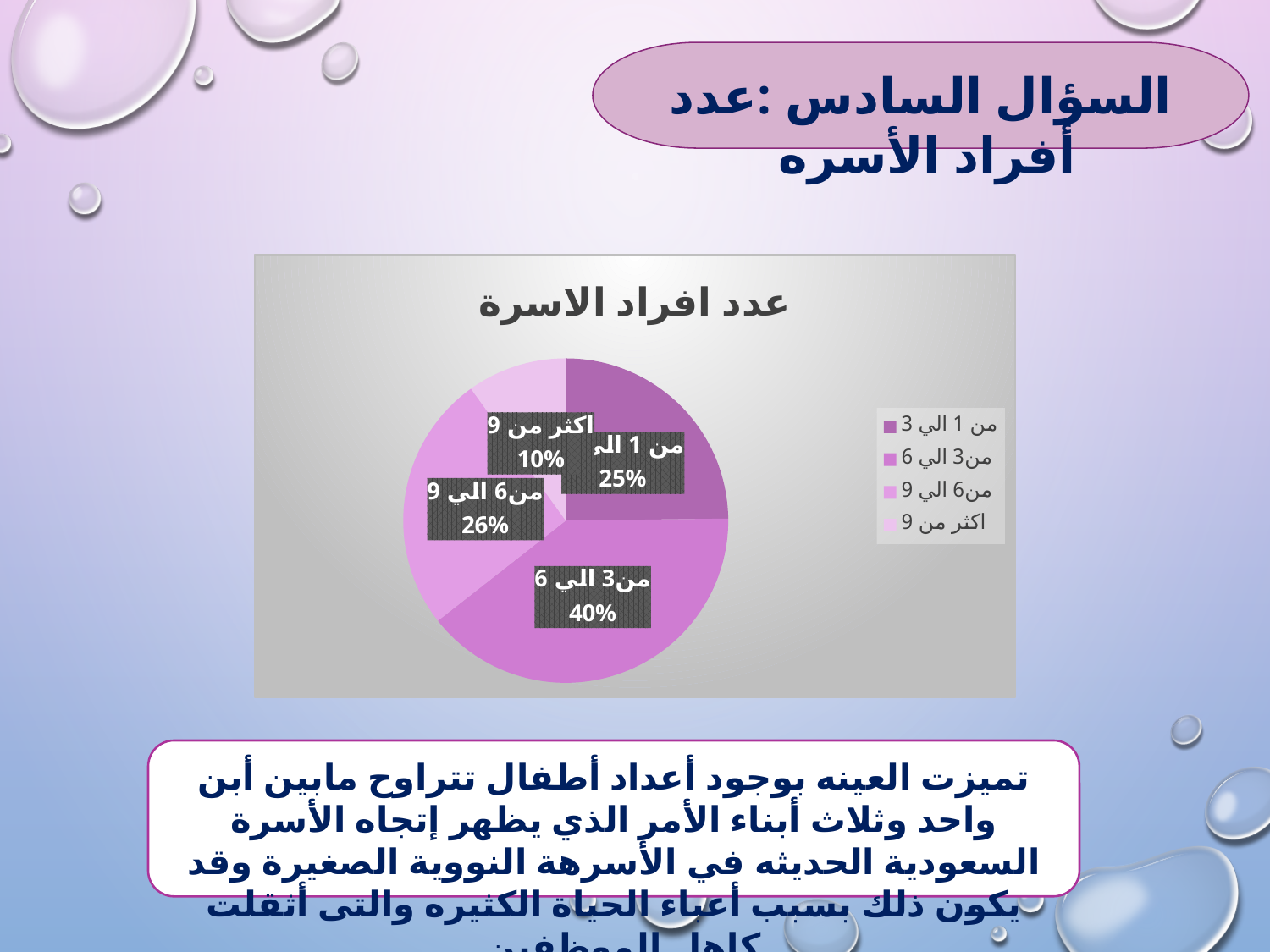
How many slices does the pie chart have? 4 Which category has the smallest share of the pie? اكثر من 9 What percentage of the pie does the slice 'من 1 الي 3' represent? 25% How many entries does the legend list? 4 Which category has the largest share of the pie? من3 الي 6 What percentage of the pie does the slice 'اكثر من 9' represent? 10% What kind of chart is shown on the slide? pie chart What percentage of the pie does the slice 'من3 الي 6' represent? 40% What percentage of the pie does the slice 'من6 الي 9' represent? 26% What is the difference in percentage points between the 'من3 الي 6' slice and the 'اكثر من 9' slice? 30 What is the title of the chart? عدد افراد الاسرة Which is larger, the share for 'من 1 الي 3' or the share for 'اكثر من 9'? من 1 الي 3